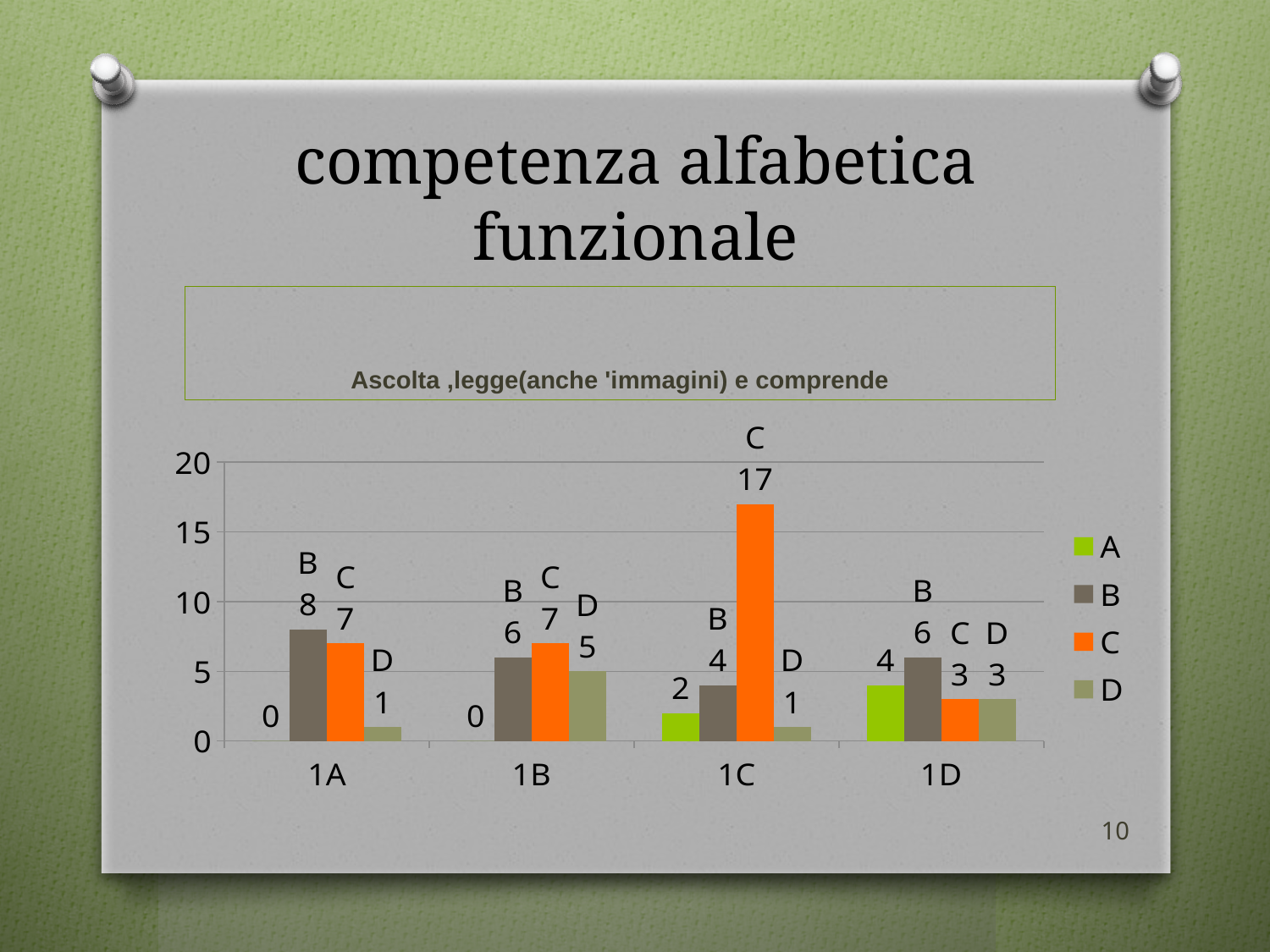
What kind of chart is shown on the slide? bar chart What is the value of series B for class 1A? 8 How many classes are shown on the x axis? 4 What is the value of series A for class 1D? 4 What is the difference between the series C value for 1C and the series C value for 1D? 14 What is the title of the chart? Ascolta ,legge(anche 'immagini) e comprende Which class has the highest value for series C? 1C What is the value of series D for class 1B? 5 How many series does the legend list? 4 Which is larger for class 1B: series B or series C? C What is the value of series C for class 1C? 17 Which class has the lowest value for series B? 1C